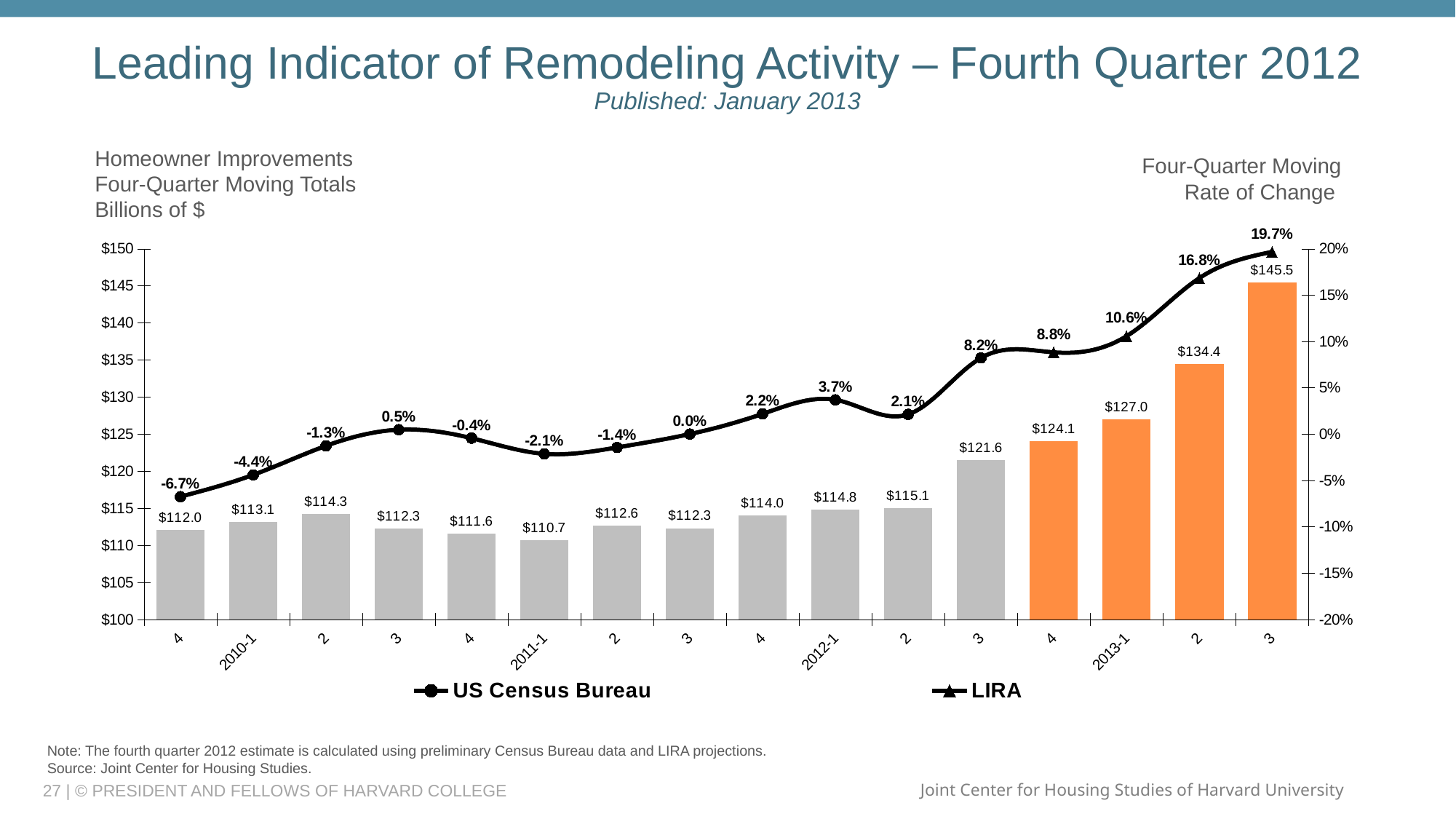
Which quarter has the lowest four-quarter moving total? 2011-1 Which is larger, the four-quarter moving total for 2010-1 or for 2011-1? 2010-1 How many bars (quarters) are plotted on the chart? 16 Which quarter has the highest four-quarter moving total? 2013 quarter 3 What is the difference between the four-quarter moving totals for 2013 quarter 3 and 2013 quarter 2? $11.1 What is the four-quarter moving total for 2011-1? $110.7 What is the four-quarter moving total for the last bar, 2013 quarter 3? $145.5 What is the lowest four-quarter moving rate of change shown on the line? -6.7% How many series does the legend list? 2 What kind of chart is this? Combined bar and line chart What is the four-quarter moving rate of change for 2012-1? 3.7% Which series in the legend is marked with triangle markers? LIRA